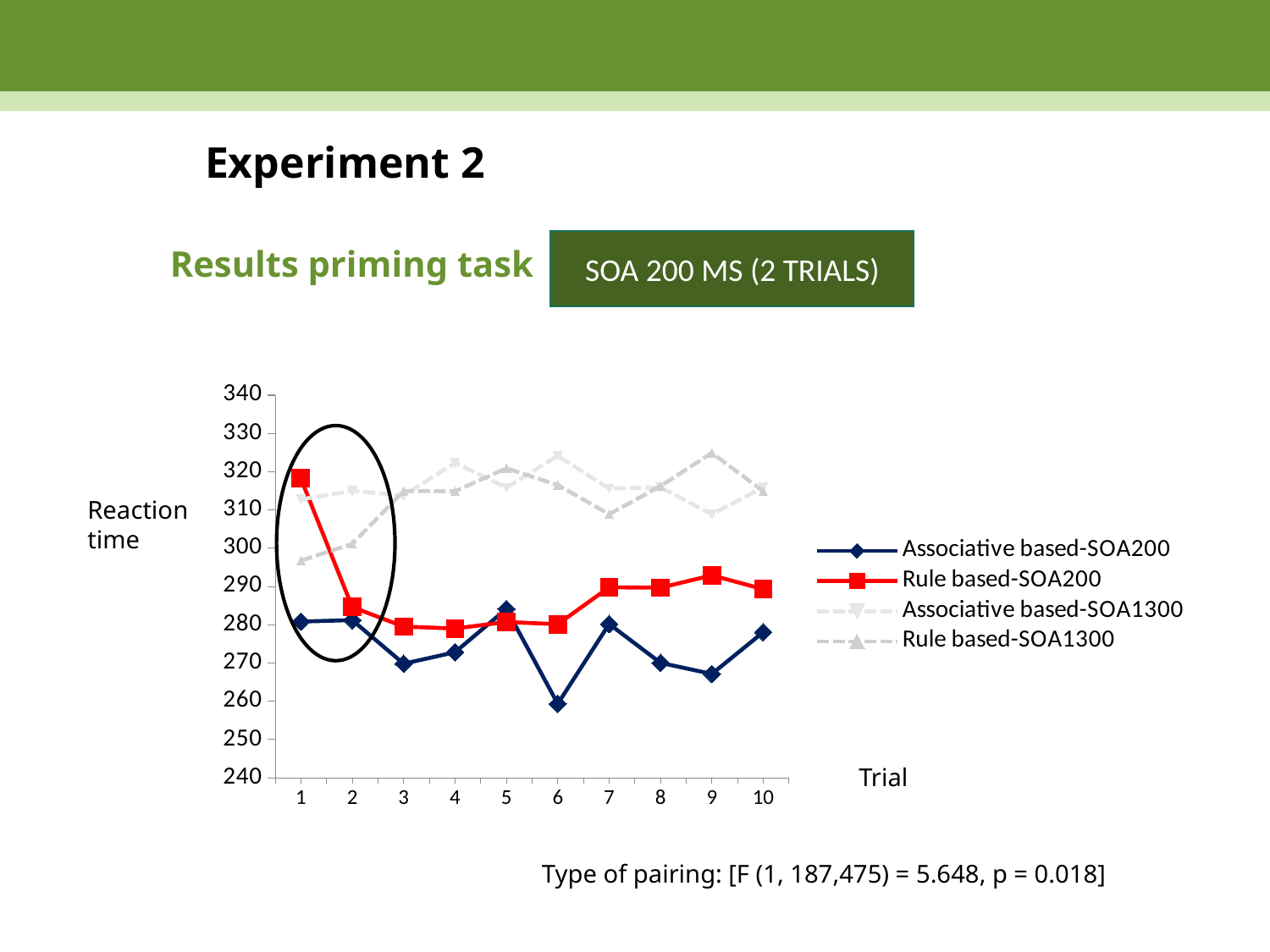
At which trial does the Associative based-SOA200 series reach its lowest value? 6 Does the Rule based-SOA200 series rise or fall from trial 1 to trial 2? fall At trial 1, which is higher: Rule based-SOA200 or Associative based-SOA200? Rule based-SOA200 How many series does the legend list? 4 What is the label of the y axis? Reaction time What kind of chart is shown on the slide? line chart How many trials are plotted along the x axis? 10 At which trial does the Rule based-SOA200 series reach its highest value? 1 What is the label of the x axis? Trial Is the value for Associative based-SOA200 at trial 6 greater or less than 270? less Is the value for Rule based-SOA200 at trial 9 greater or less than 280? greater Is the value for Rule based-SOA200 at trial 1 greater or less than 310? greater